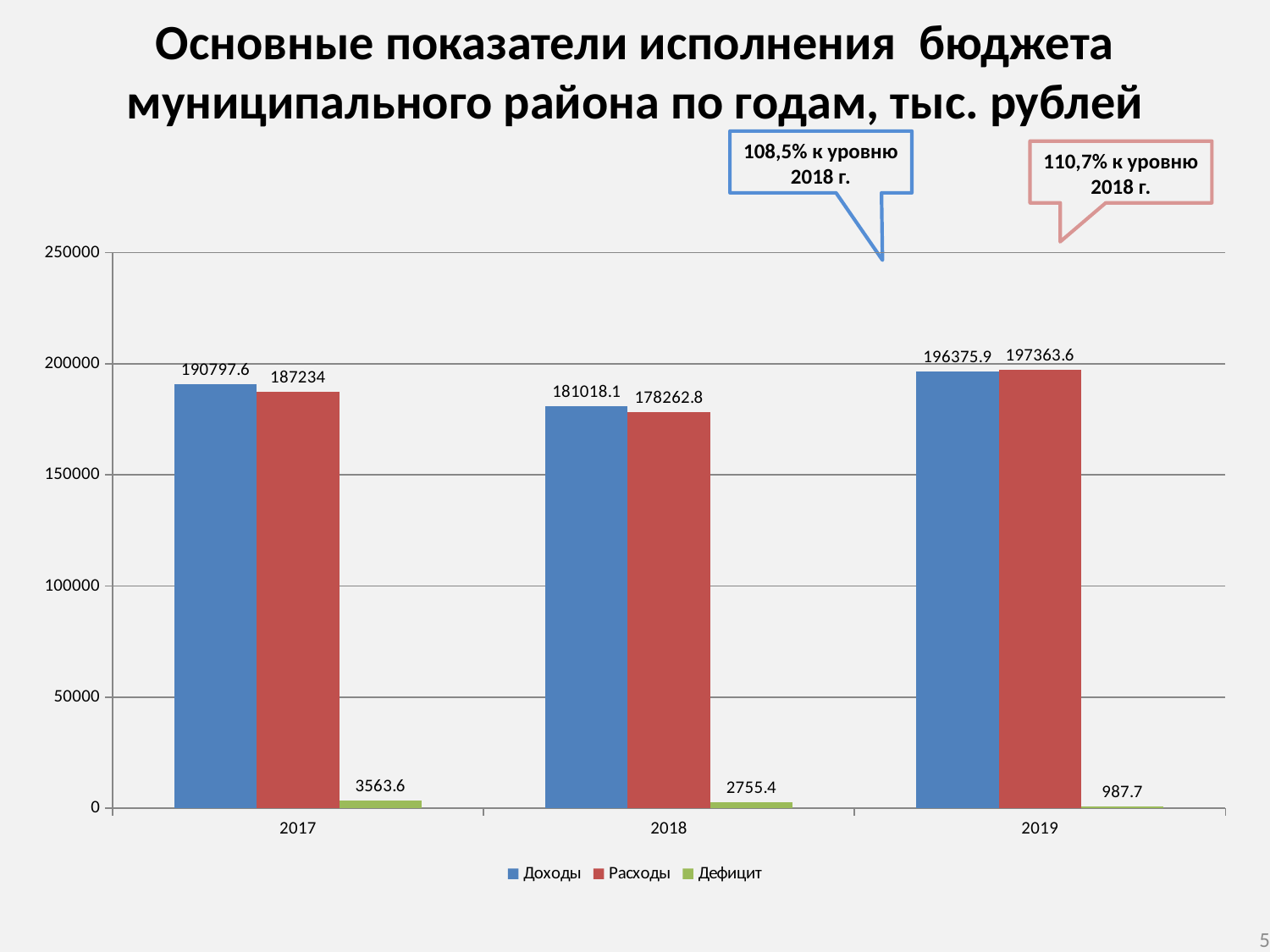
In which year is Доходы the highest? 2019 Which is larger in 2017, Доходы or Расходы? Доходы What is the value of Дефицит for 2019? 987.7 What is the value of Расходы for 2019? 197363.6 In which year is Дефицит the lowest? 2019 How many series does the legend list? 3 What kind of chart is shown on the slide? bar chart How many years are shown on the x axis? 3 What is the difference between Доходы in 2019 and Доходы in 2018? 15357.8 What is the value of Расходы for 2018? 178262.8 Does Дефицит rise or fall from 2017 to 2019? fall What is the value of Доходы for 2017? 190797.6